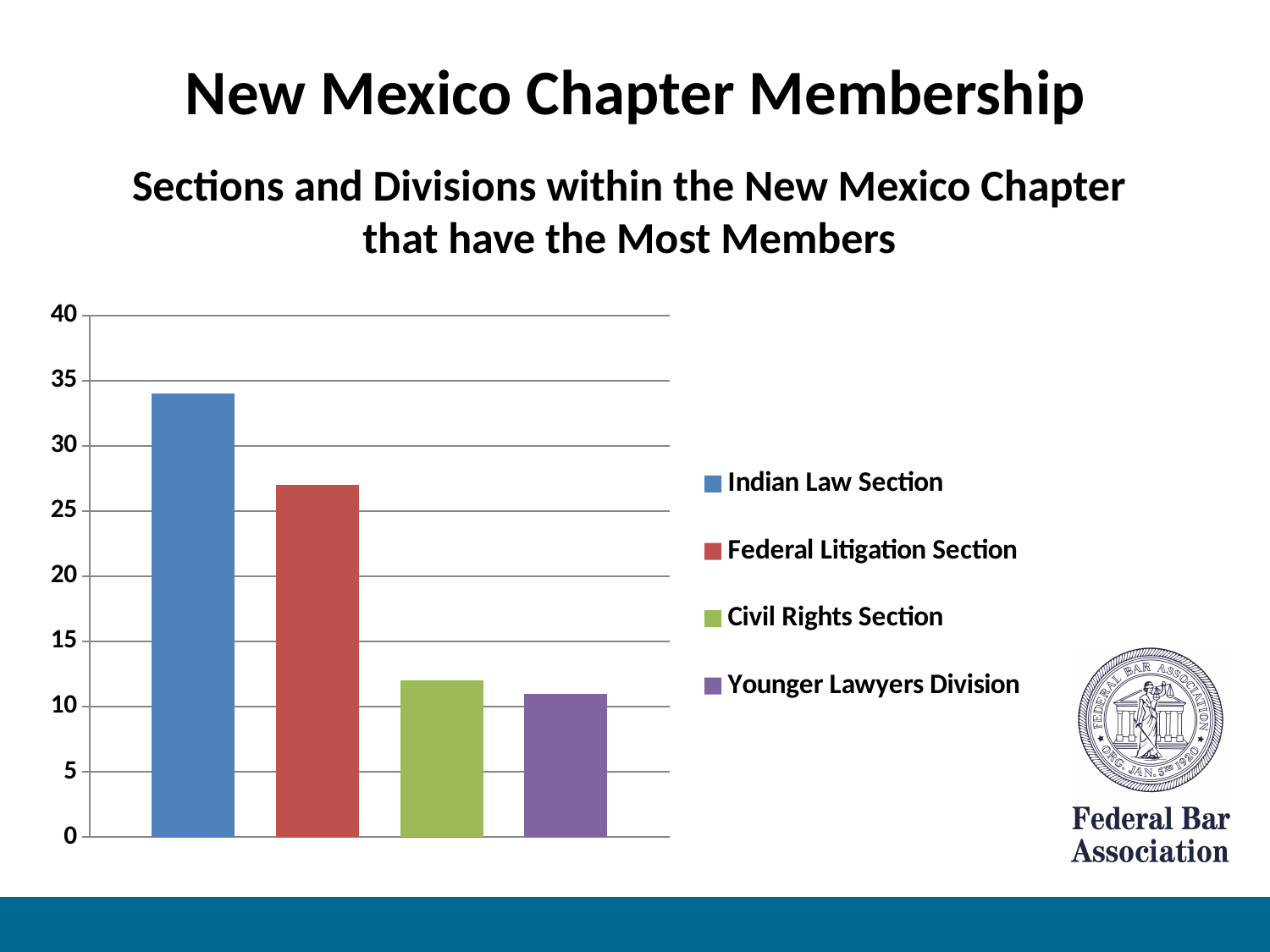
How many series does the legend list? 4 Which is larger, the value for Indian Law Section or the value for Federal Litigation Section? Indian Law Section Is the value for Federal Litigation Section greater or less than 25? greater Is the value for Civil Rights Section greater or less than 15? less How many bars are plotted in the chart? 4 Which is larger, the value for Federal Litigation Section or the value for Civil Rights Section? Federal Litigation Section What colour is the bar for the Civil Rights Section? green Is the value for Indian Law Section greater or less than 30? greater Which section or division has the highest number of members? Indian Law Section What kind of chart is shown on the slide? bar chart